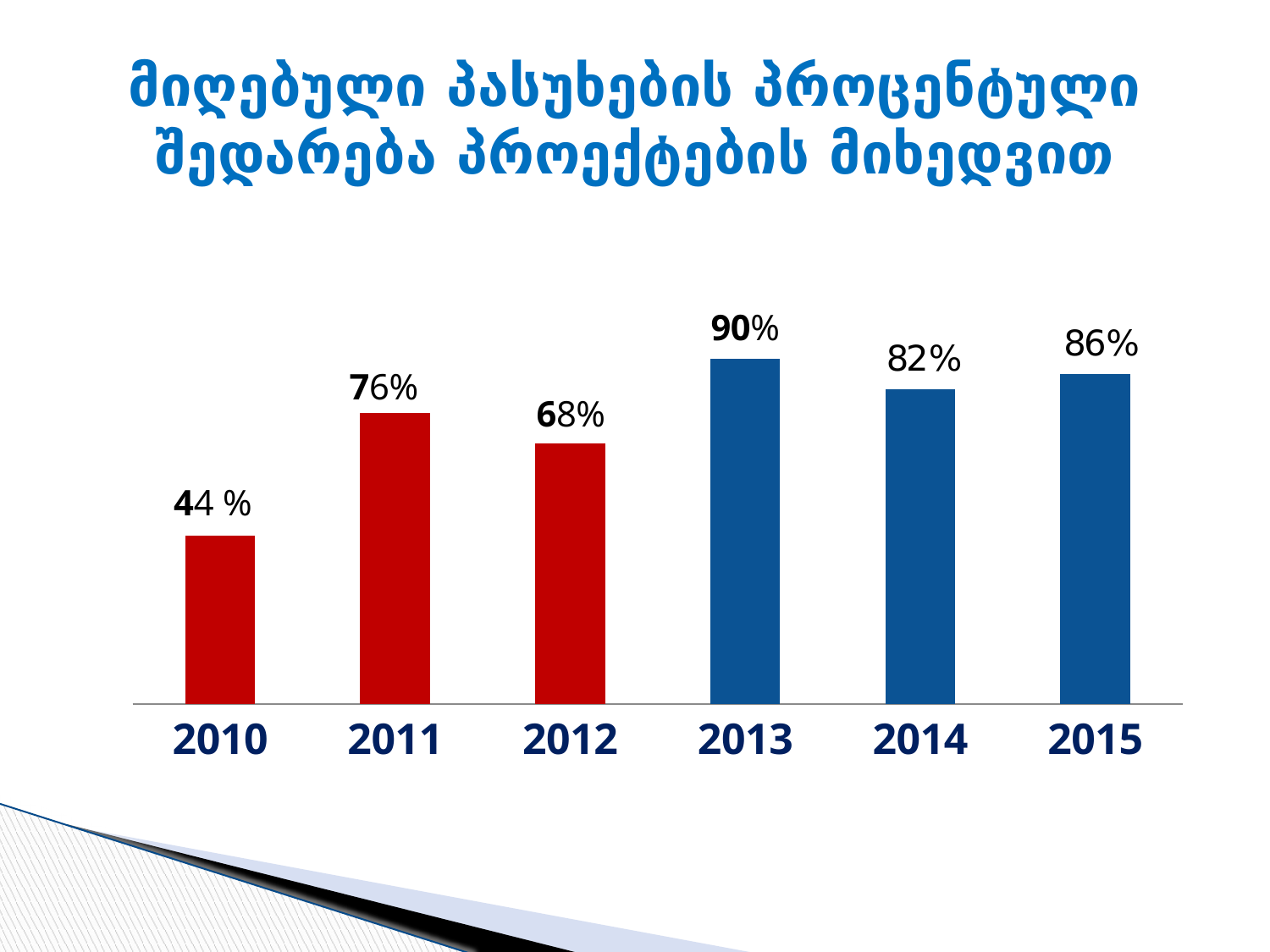
What kind of chart is shown on the slide? Bar chart Which year has the lowest value? 2010 How many years are shown on the x axis? 6 What is the difference between the values for 2013 and 2010? 46 percentage points What is the value for 2012? 68% What colour are the bars for 2013, 2014 and 2015? Blue Which year has the highest value? 2013 What is the difference between the values for 2011 and 2012? 8 percentage points What is the value for 2013? 90% What is the value for 2015? 86% Which is larger, the value for 2014 or the value for 2015? 2015 What is the value for 2010? 44 %